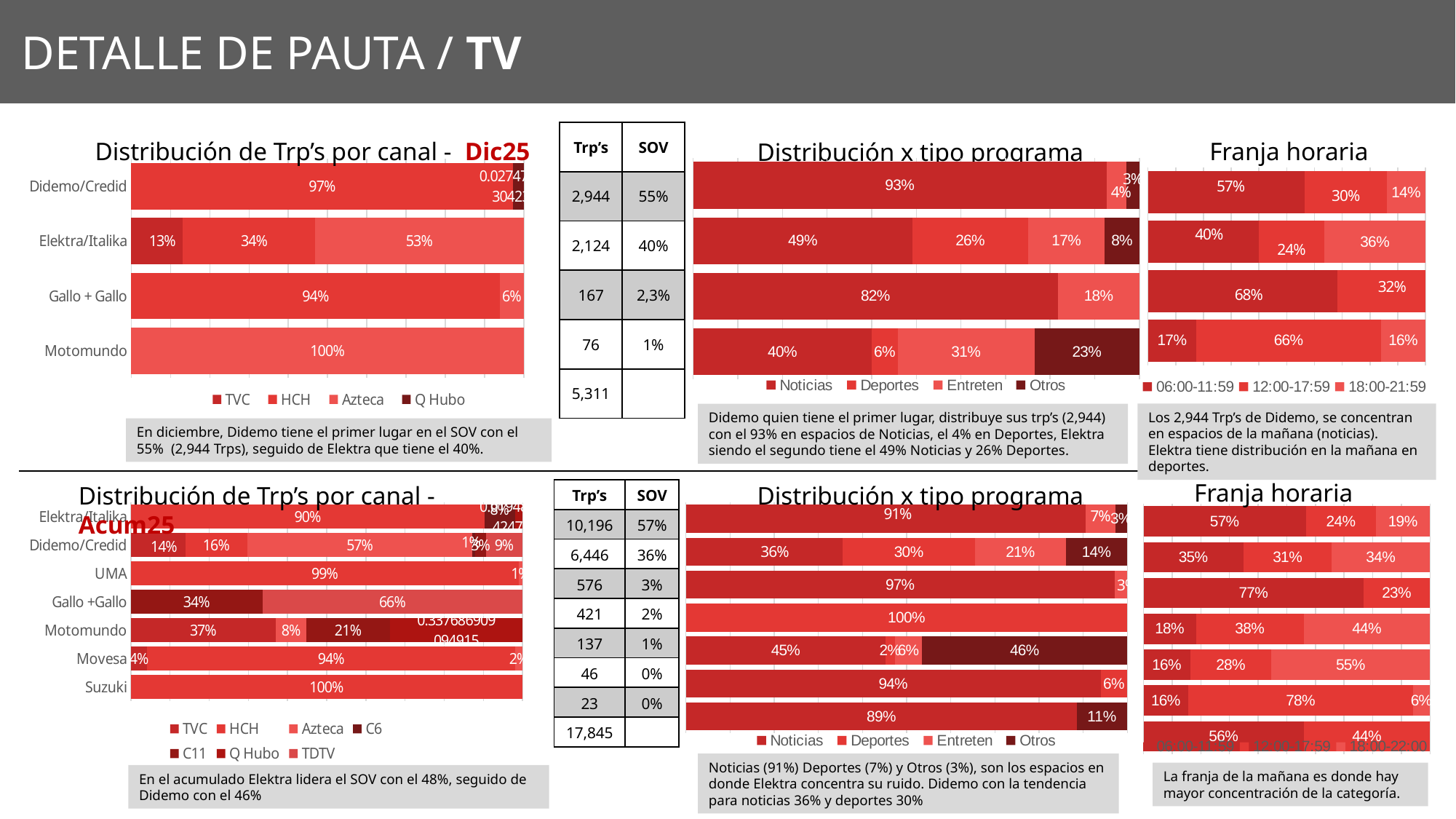
In the top 'Franja horaria' chart, what percentage does the 06:00-11:59 segment of the top bar show? 57% In the 'Distribución de Trp's por canal - Acum25' chart, what percentage is shown for Suzuki? 100% How many series does the legend of the 'Distribución de Trp's por canal - Dic25' chart list? 4 How many channel categories are shown in the 'Distribución de Trp's por canal - Acum25' chart? 7 In the top 'Distribución x tipo programa' chart, what percentage does the Noticias segment of the top bar show? 93% In the 'Distribución de Trp's por canal - Dic25' chart, what percentage is shown for Motomundo? 100% How many series does the legend of the 'Distribución de Trp's por canal - Acum25' chart list? 7 In the 'Distribución de Trp's por canal - Dic25' chart, what percentage does the Azteca segment show for Elektra/Italika? 53% What are the legend entries of the top 'Franja horaria' chart? 06:00-11:59, 12:00-17:59, 18:00-21:59 What kind of chart is the 'Distribución de Trp's por canal - Dic25' chart? Bar chart In the 'Distribución de Trp's por canal - Dic25' chart, which is larger: the 94% segment for Gallo + Gallo or the Azteca segment for Elektra/Italika? Gallo + Gallo In the 'Distribución de Trp's por canal - Dic25' chart, what is the difference between the HCH and TVC percentages for Elektra/Italika? 21 percentage points